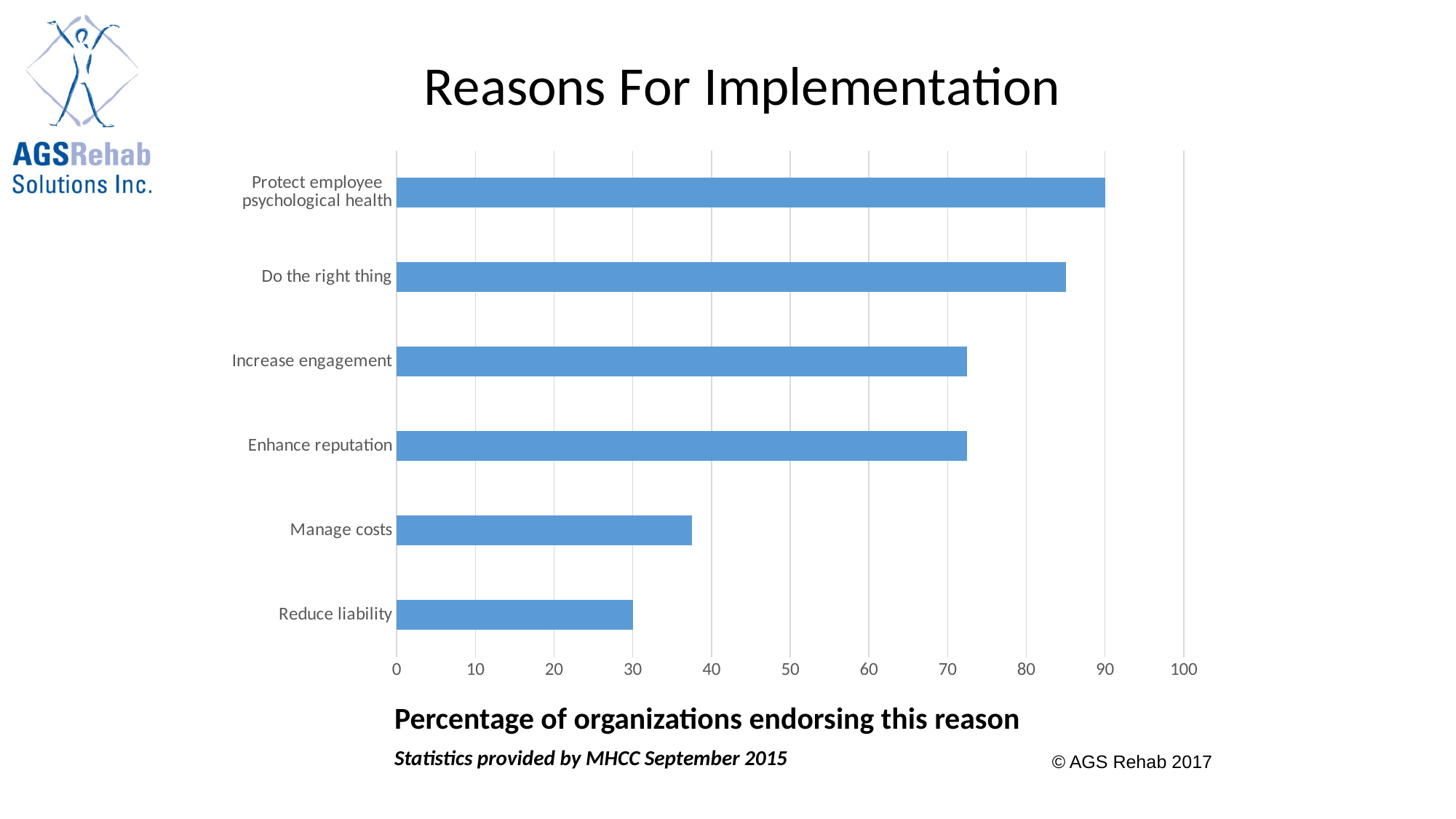
Which is larger, the value for 'Do the right thing' or the value for 'Manage costs'? Do the right thing What percentage of organizations endorse 'Protect employee psychological health'? 90 Which reason has the highest percentage of organizations endorsing it? Protect employee psychological health What is the title of the chart? Reasons For Implementation Which reason has the lowest percentage of organizations endorsing it? Reduce liability Is the value for 'Manage costs' greater or less than 40? less Is the value for 'Enhance reputation' greater or less than 80? less How many reasons (categories) are plotted in the chart? 6 Is the value for 'Increase engagement' greater or less than 70? greater What percentage of organizations endorse 'Reduce liability'? 30 What type of chart is shown on the slide? Bar chart